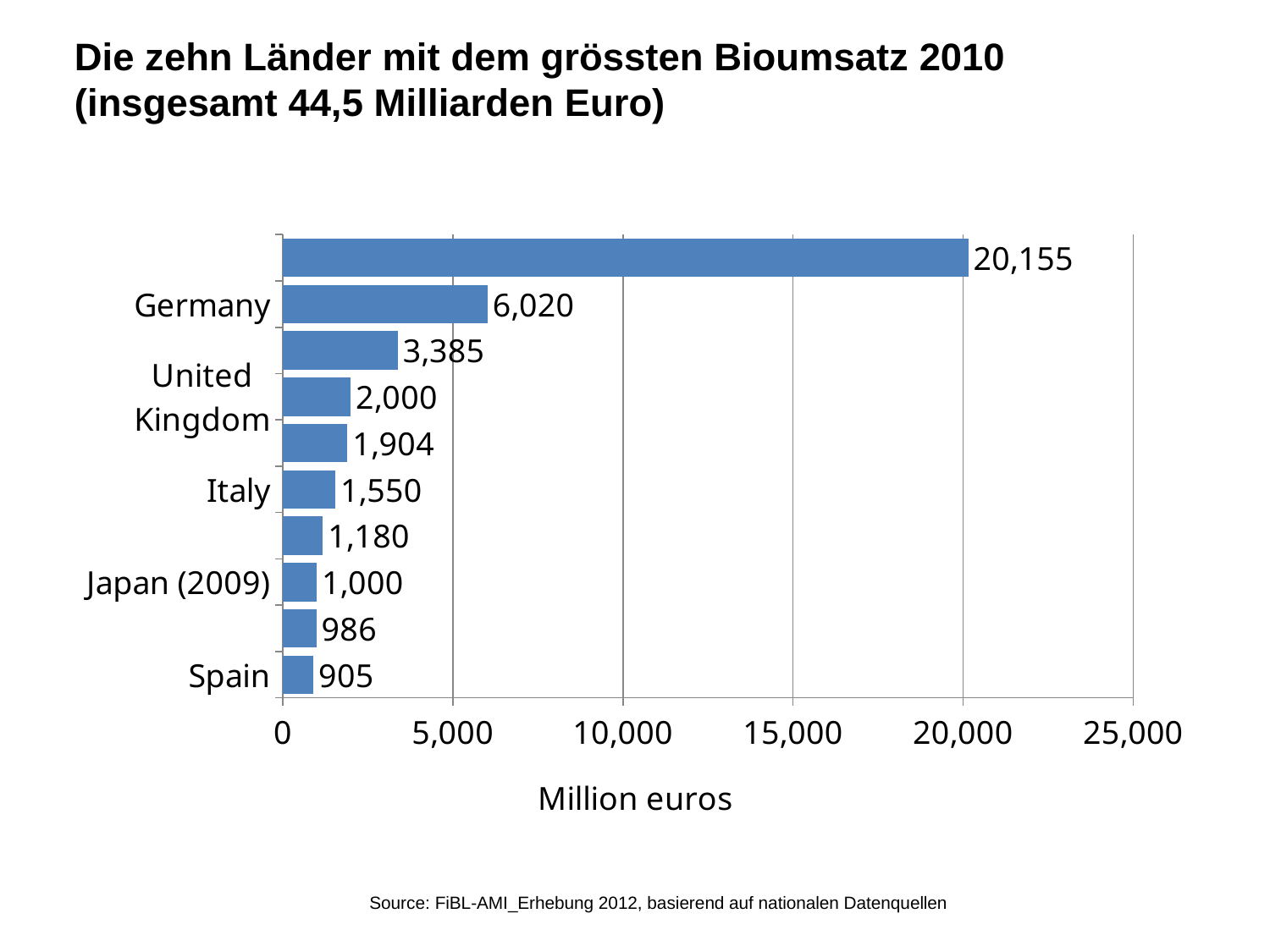
What is the value of the longest bar in the chart? 20,155 What is the value for Japan (2009)? 1,000 What is the value for Italy? 1,550 Is the value for Germany greater or less than 5,000? greater What is the value for Germany? 6,020 What is the difference between the values for Germany and United Kingdom? 4,020 Which labelled country has the lowest value? Spain What is the value for United Kingdom? 2,000 Which is larger, the value for Italy or the value for Japan (2009)? Italy What is the value for Spain? 905 What is the title of the horizontal axis? Million euros How many bars are shown in the chart? 10